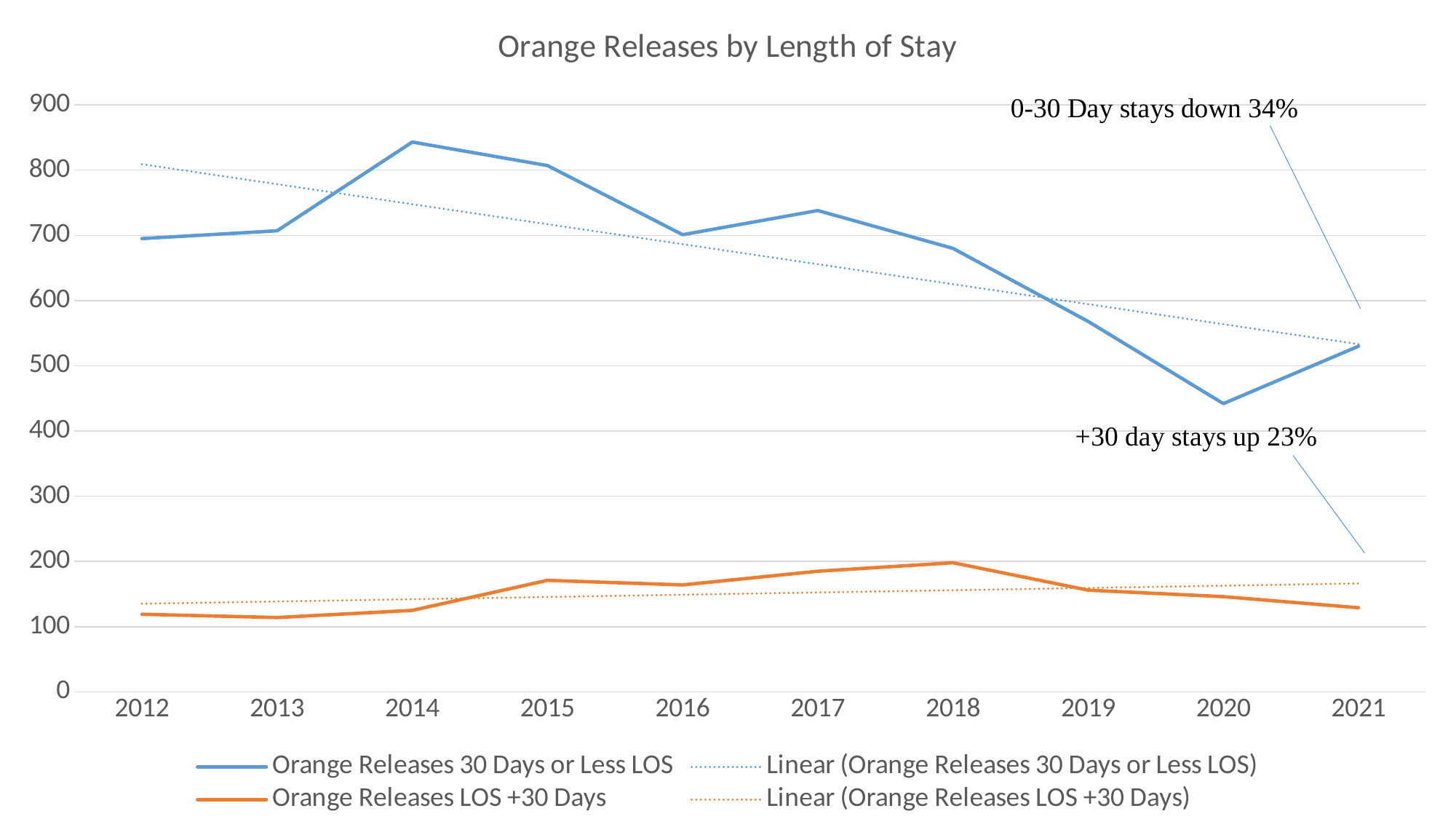
In which year does the Orange Releases LOS +30 Days series reach its highest value? 2018 How many entries does the legend list? 4 Which year has the higher value for Orange Releases 30 Days or Less LOS, 2016 or 2017? 2017 What is the title of the chart? Orange Releases by Length of Stay What type of chart is shown on the slide? line chart Is the value for Orange Releases 30 Days or Less LOS in 2020 greater or less than 500? less In which year does the Orange Releases 30 Days or Less LOS series reach its highest value? 2014 Is the value for Orange Releases 30 Days or Less LOS in 2014 greater or less than 800? greater Does the linear trendline for Orange Releases 30 Days or Less LOS rise or fall from 2012 to 2021? fall In which year does the Orange Releases 30 Days or Less LOS series reach its lowest value? 2020 Is the value for Orange Releases LOS +30 Days in 2015 greater or less than 150? greater How many years are plotted along the x axis? 10